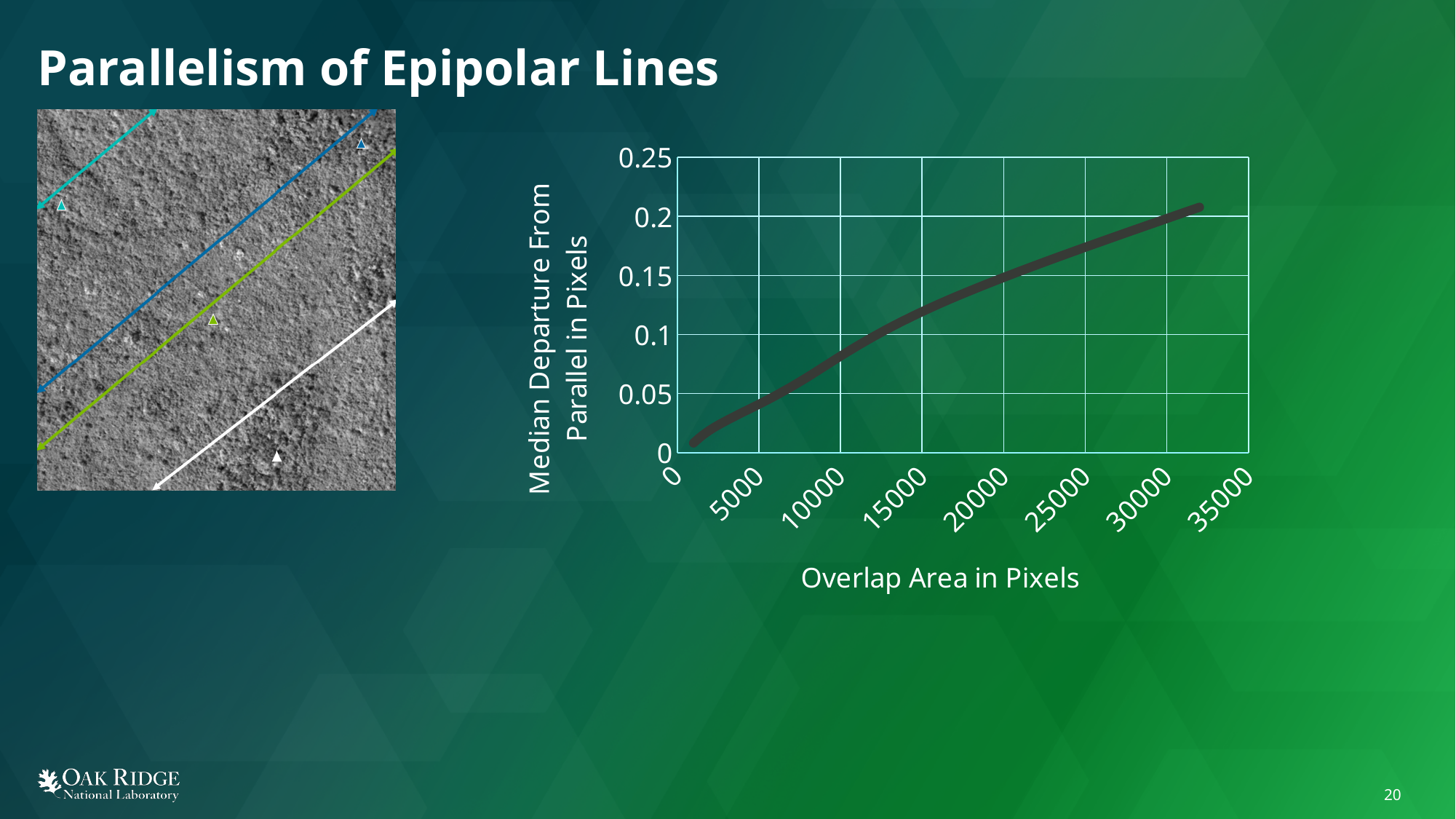
Is the value at an overlap area of 10000 pixels greater or less than 0.05? greater What kind of chart is shown on the slide? line chart What is the title of the y axis of the chart? Median Departure From Parallel in Pixels Is the value at an overlap area of 10000 pixels greater or less than 0.1? less Is the value at the right end of the line greater or less than 0.2? greater Does the median departure from parallel rise or fall as the overlap area increases? rise What is the title of the x axis of the chart? Overlap Area in Pixels